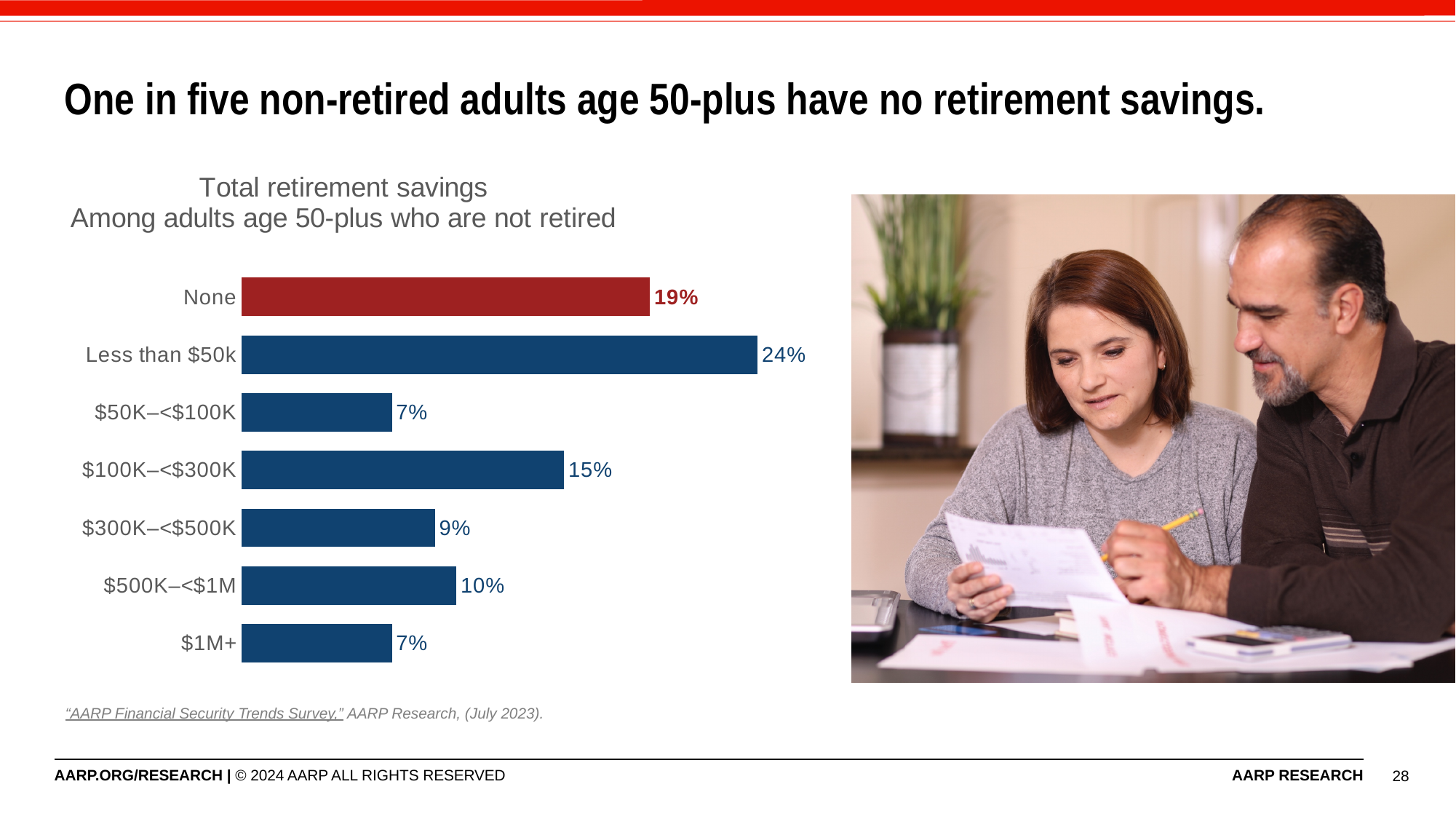
What is the difference between the "$100K–<$300K" value and the "$300K–<$500K" value? 6% Which bar is coloured red rather than blue? None What is the value for the "$100K–<$300K" category? 15% What is the value for the "Less than $50k" category? 24% What is the value for the "$500K–<$1M" category? 10% Which category has the highest value? Less than $50k Which categories share the lowest value of 7%? $50K–<$100K and $1M+ What is the difference between the "Less than $50k" value and the "None" value? 5% How many categories are shown in the chart? 7 What kind of chart is shown on the slide? Bar chart What percentage of non-retired adults age 50-plus have no retirement savings (the "None" category)? 19% Which is larger, the value for "$300K–<$500K" or the value for "$500K–<$1M"? $500K–<$1M